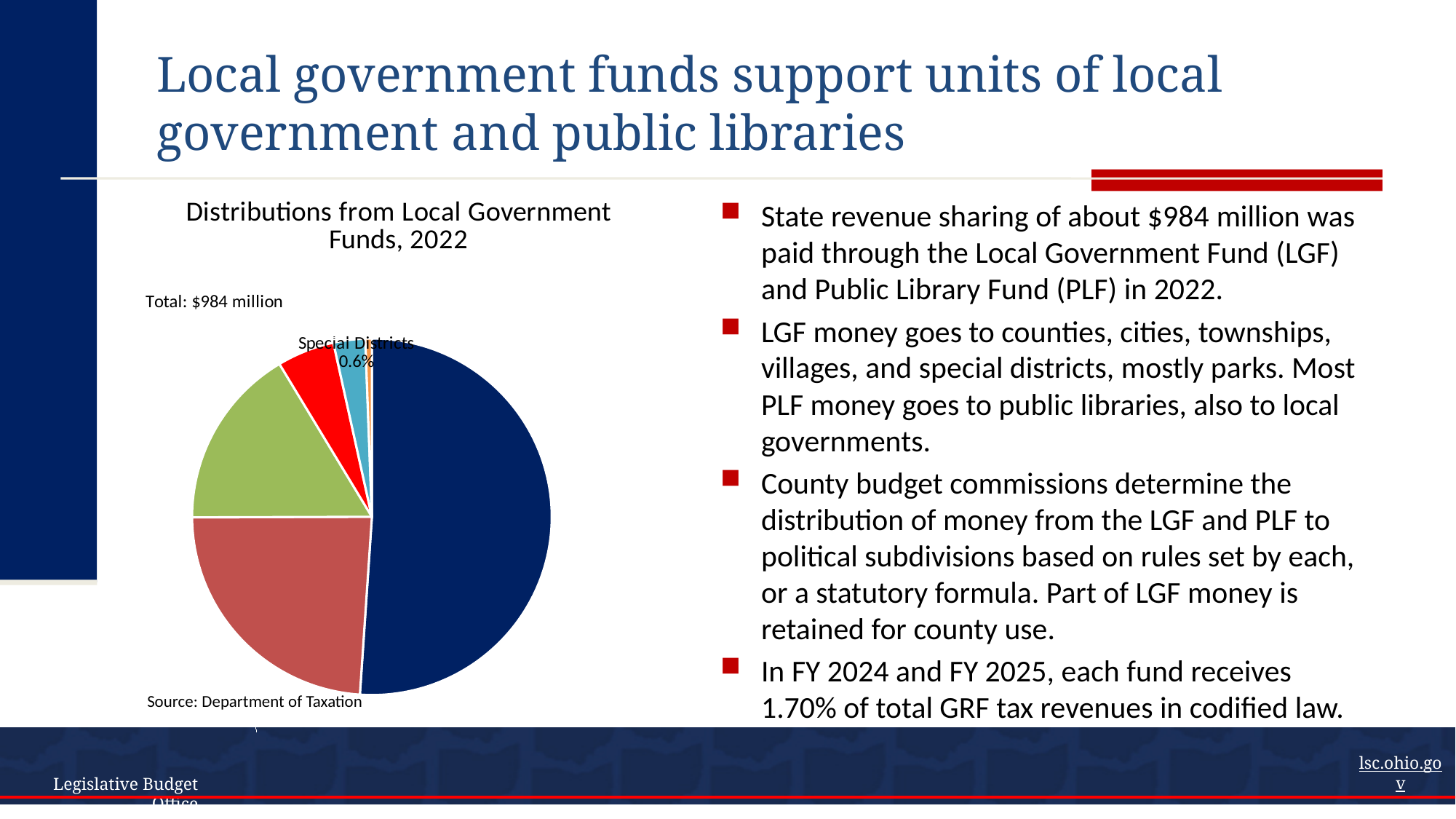
What source is cited below the chart? Department of Taxation Which colour slice is the largest in the pie chart? dark blue Is the share for Special Districts greater or less than 1%? less How many slices does the pie chart have? 6 What total amount is stated for the pie chart? $984 million Is the Special Districts slice the smallest slice in the pie chart? yes What kind of chart is shown on the slide? pie chart What is the title of the chart on the slide? Distributions from Local Government Funds, 2022 What share of the pie does Special Districts represent? 0.6% Which is larger in the pie chart: the dark blue slice or the green slice? dark blue